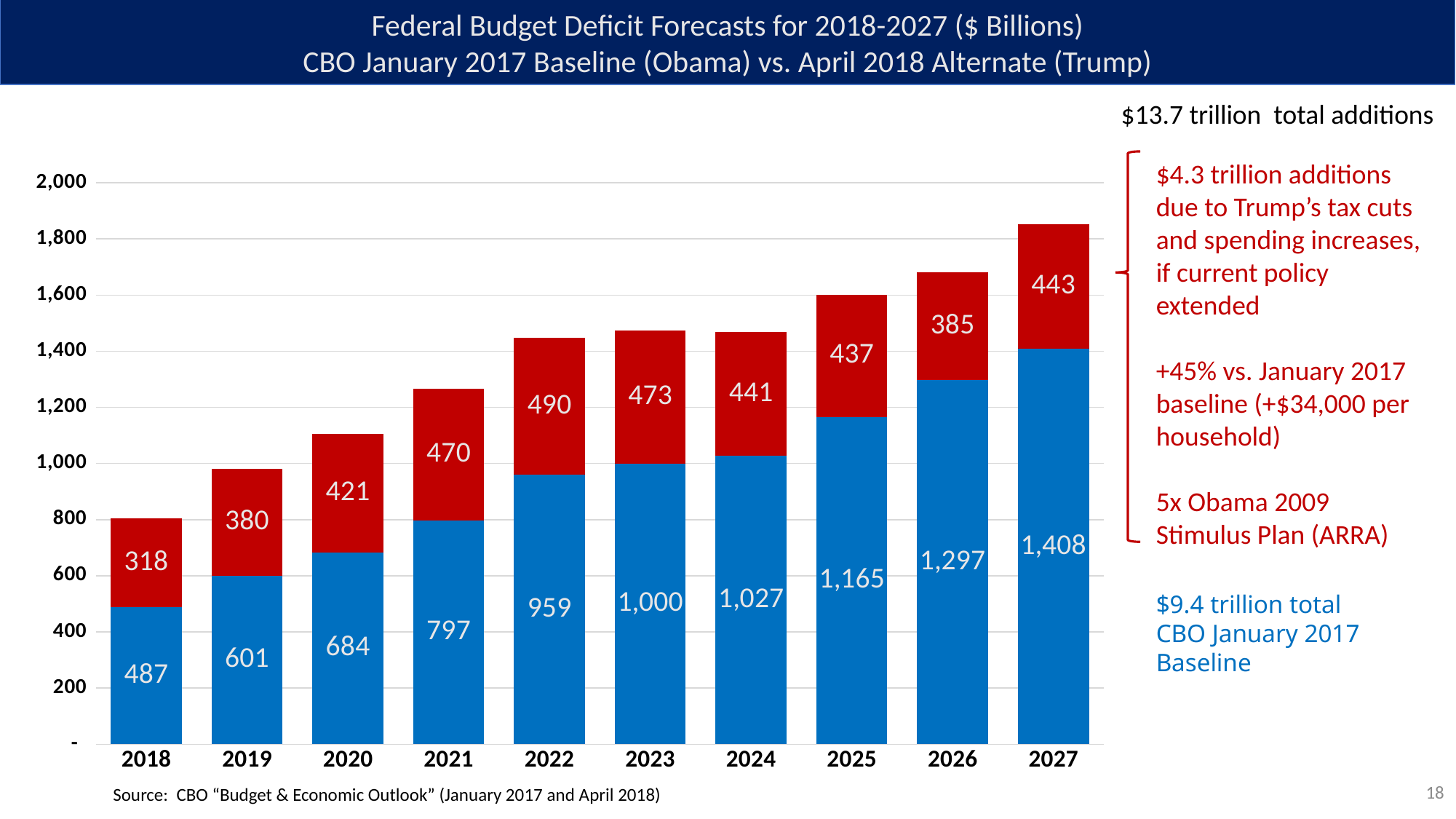
What is the total of the stacked bar for 2020? 1,105 What is the value of the red (additions) segment for 2025? 437 How many years are shown on the x axis? 10 What is the difference between the blue segment values for 2027 and 2018? 921 Which year has the largest red (additions) segment? 2022 Is the total height of the 2024 stacked bar greater or less than 1,400? greater Which year has the smallest blue (baseline) segment? 2018 Which is larger, the red segment for 2021 or the red segment for 2026? 2021 What kind of chart is shown on the slide? Stacked bar chart What is the value of the blue (CBO January 2017 Baseline) segment for 2022? 959 What is the value of the blue segment for 2027? 1,408 Do the blue (baseline) segment values rise or fall from 2018 to 2027? Rise